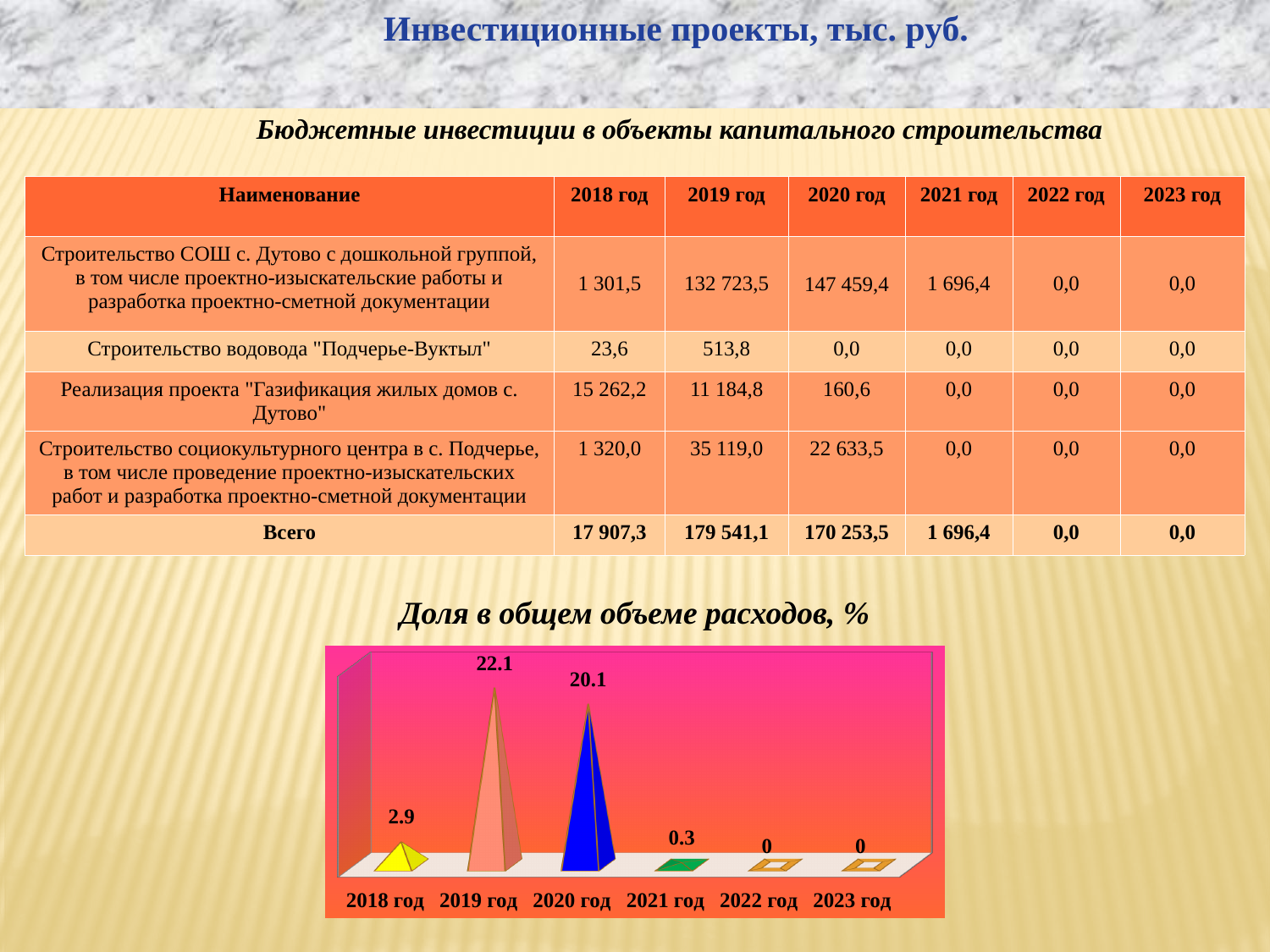
In the chart 'Доля в общем объеме расходов, %', do the values rise or fall from 2019 год to 2023 год? fall What is the difference between the values for 2019 год and 2020 год in the chart 'Доля в общем объеме расходов, %'? 2 In the chart 'Доля в общем объеме расходов, %', which is larger: the value for 2018 год or the value for 2021 год? 2018 год What is the value for 2018 год in the chart 'Доля в общем объеме расходов, %'? 2.9 What is the difference between the values for 2018 год and 2021 год in the chart 'Доля в общем объеме расходов, %'? 2.6 What kind of chart is 'Доля в общем объеме расходов, %'? bar chart Which year has the highest value in the chart 'Доля в общем объеме расходов, %'? 2019 год How many years are shown on the x axis of the chart 'Доля в общем объеме расходов, %'? 6 What is the value for 2019 год in the chart 'Доля в общем объеме расходов, %'? 22.1 What is the value for 2020 год in the chart 'Доля в общем объеме расходов, %'? 20.1 What is the value for 2021 год in the chart 'Доля в общем объеме расходов, %'? 0.3 What is the title of the chart at the bottom of the slide? Доля в общем объеме расходов, %